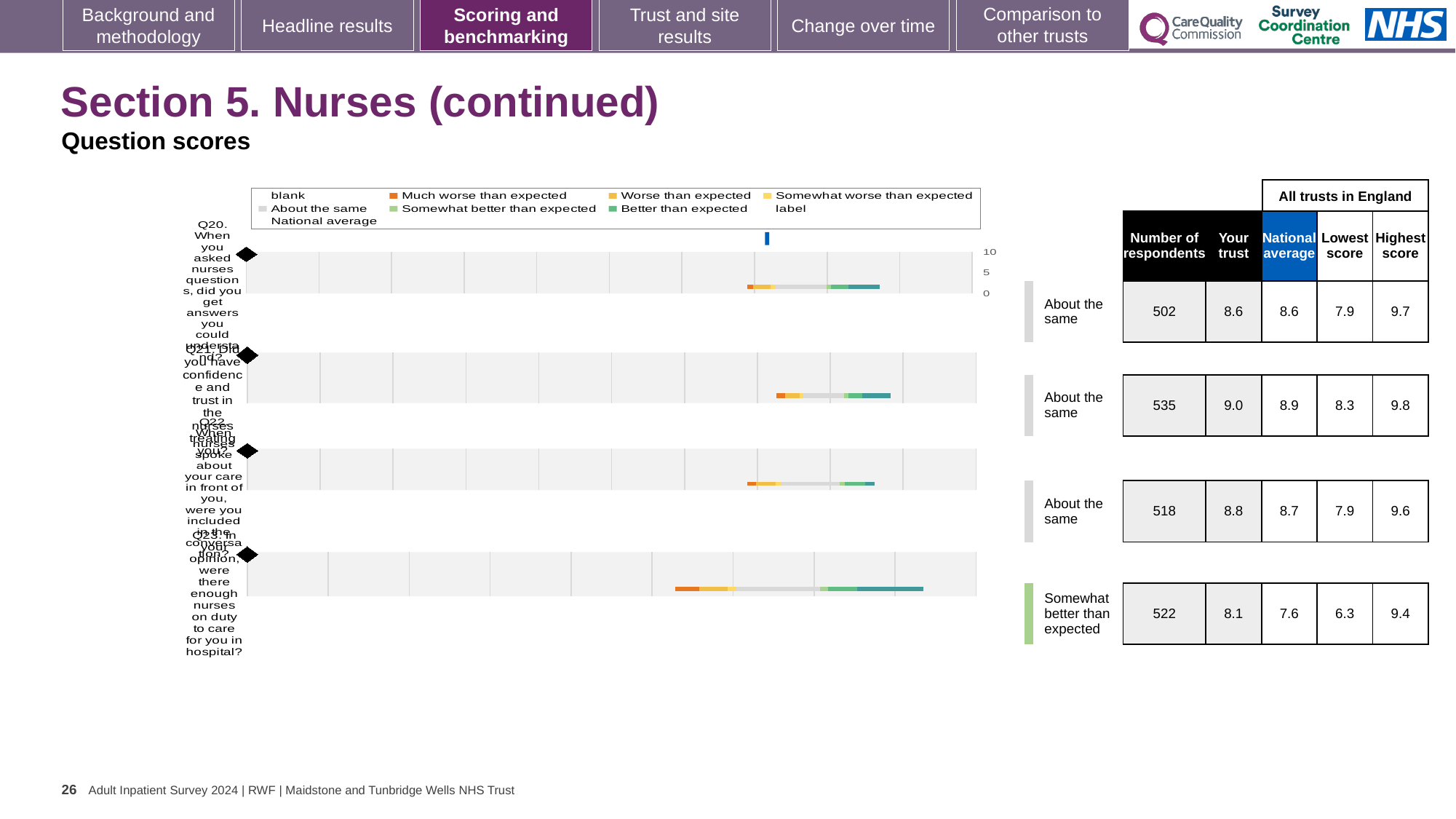
What kind of chart is used to show the question scores for Q20 to Q23? bar chart Which question has the lowest 'Your trust' score? Q23 How many questions (Q20 to Q23) are plotted as separate bars on the slide? 4 For Q23, what is the difference between the 'Your trust' score and the national average? 0.5 What is the highest score among all trusts in England shown for Q20? 9.7 How many respondents are shown for Q22 (nurses speaking about your care in front of you)? 518 How many entries does the chart legend list? 9 What is the 'Your trust' score shown for Q23 (were there enough nurses on duty)? 8.1 Which benchmark category is shown for Q23 (enough nurses on duty)? Somewhat better than expected What is the national average score shown for Q21 (confidence and trust in nurses)? 8.9 For Q22, which is larger: the 'Your trust' score or the national average? Your trust Which question has the highest 'Your trust' score? Q21